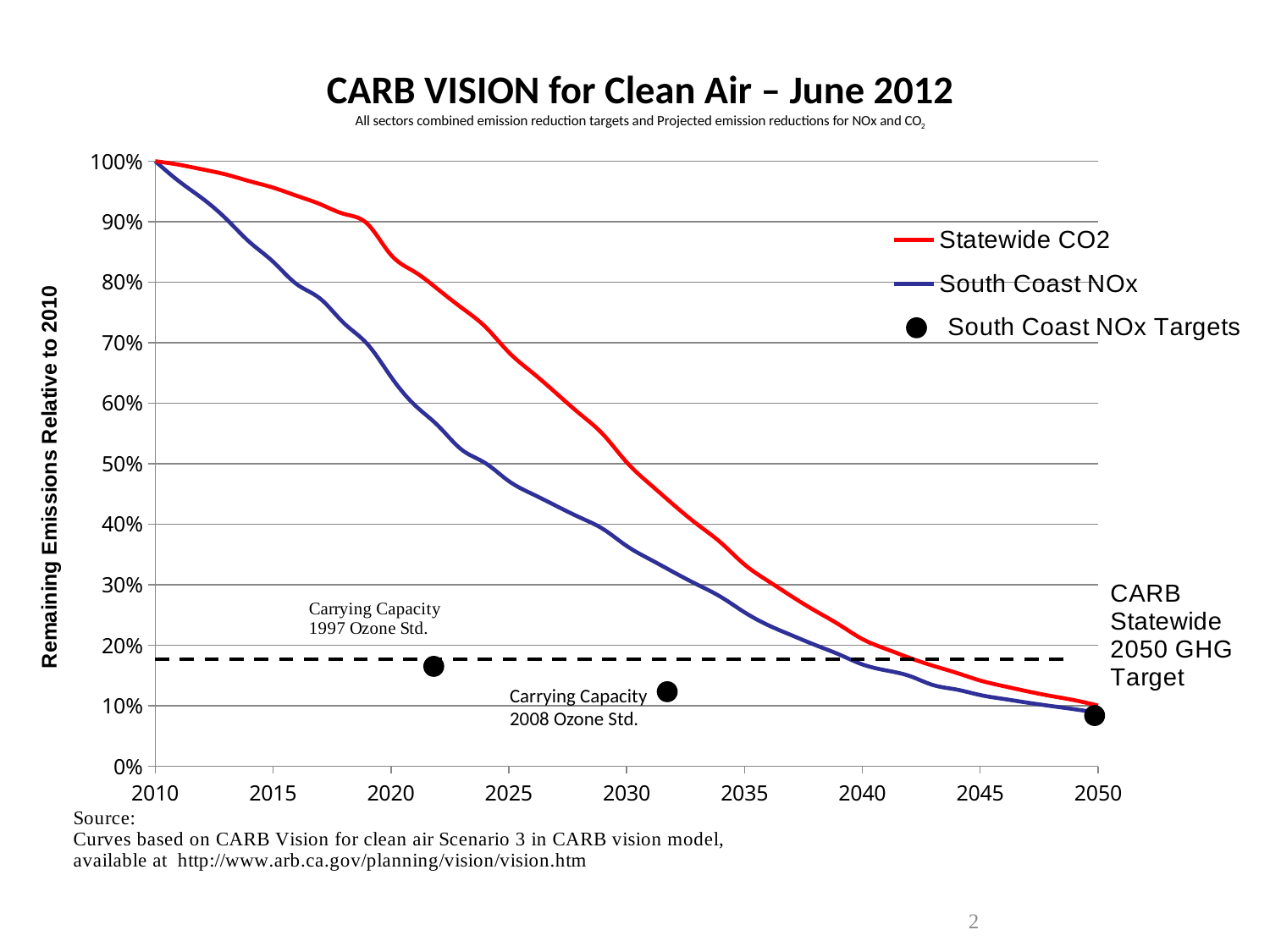
What is the value of South Coast NOx in 2010? 100% What is the title of the chart? CARB VISION for Clean Air – June 2012 What is the value of Statewide CO2 in 2010? 100% In 2030, which series has the higher value, Statewide CO2 or South Coast NOx? Statewide CO2 Which colour is used for the South Coast NOx line? blue Do the Statewide CO2 values rise or fall from 2010 to 2050? fall Is the value for South Coast NOx in 2030 greater or less than 40%? less Is the value for Statewide CO2 in 2035 greater or less than 30%? greater Is the value for South Coast NOx in 2040 greater or less than 20%? less What kind of chart is shown on the slide? line chart How many series does the legend list? 3